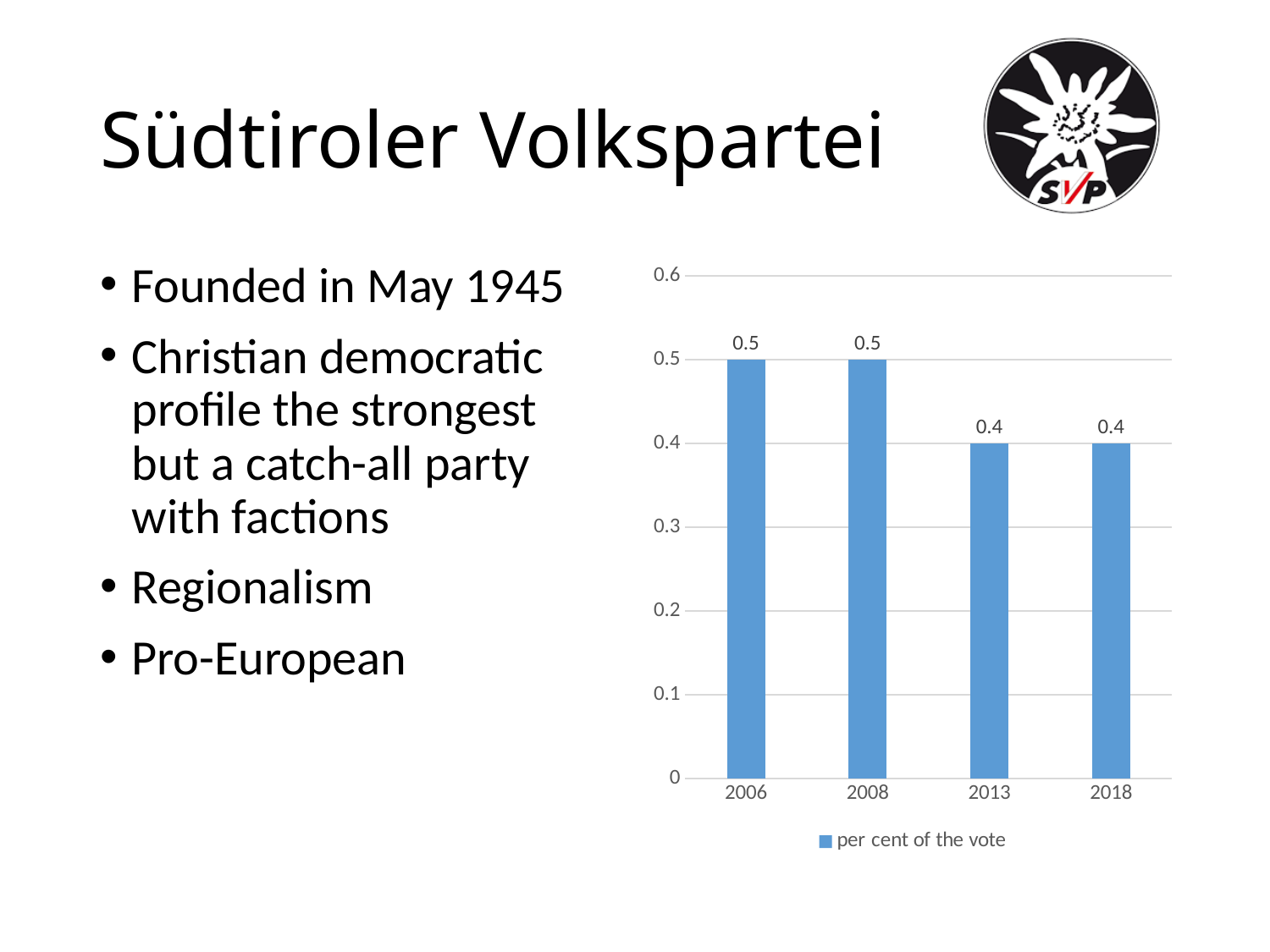
What is the value for 2018 in the chart? 0.4 What is the value for 2006 in the chart? 0.5 How many years are shown on the x axis of the chart? 4 What is the difference between the values for 2008 and 2013? 0.1 What colour are the bars in the chart? blue Which is larger, the value for 2006 or the value for 2018? 2006 What kind of chart is shown on the slide? bar chart What is the legend entry of the chart? per cent of the vote What is the value for 2013 in the chart? 0.4 Do the values rise or fall from 2006 to 2018? fall How many series does the chart legend list? 1 Is the value for 2013 greater or less than 0.5? less